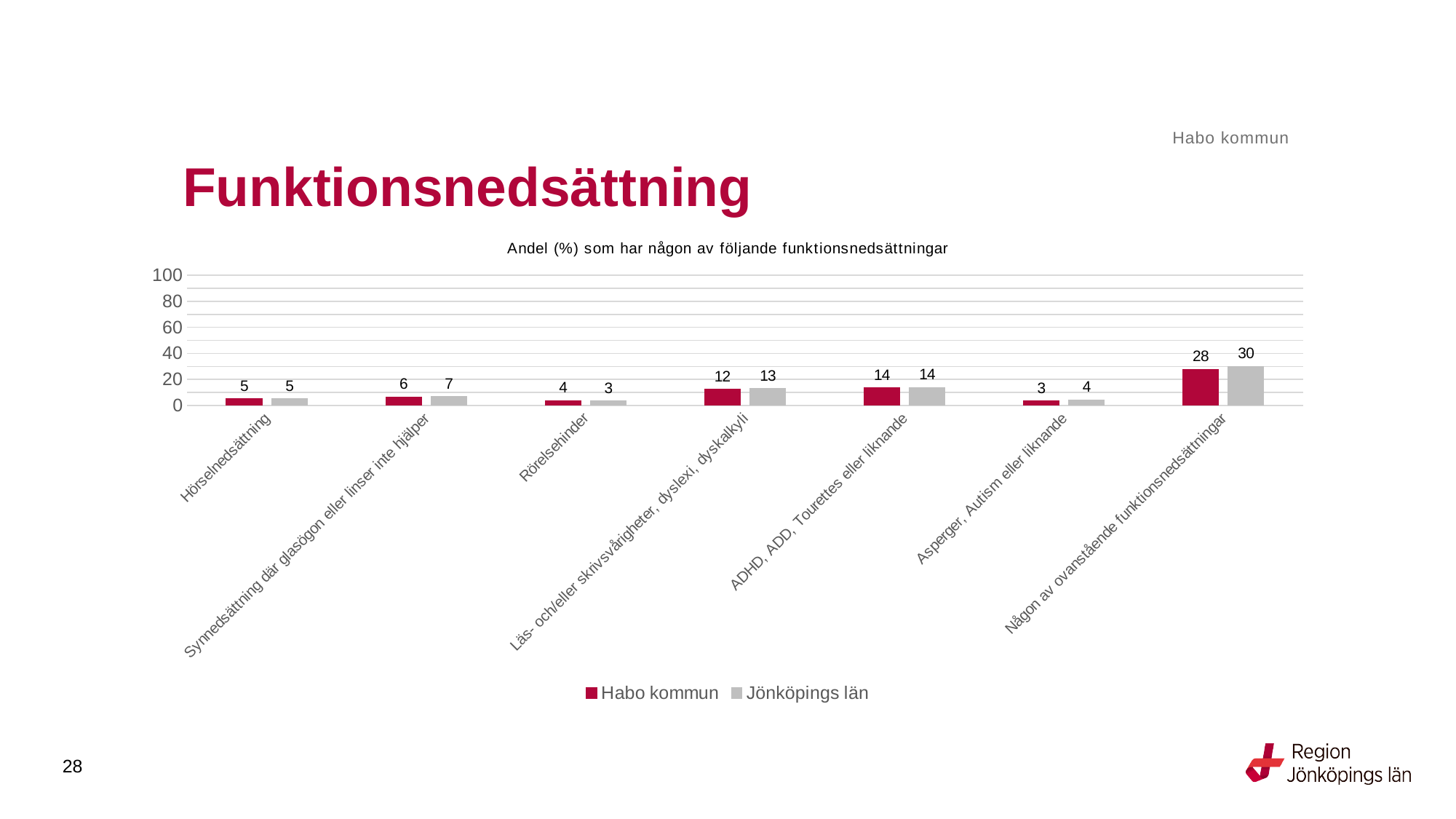
What is the value for Jönköpings län for Någon av ovanstående funktionsnedsättningar? 30 What is the value for Jönköpings län for Synnedsättning där glasögon eller linser inte hjälper? 7 How many categories are shown on the x axis? 7 What is the difference between Jönköpings län and Habo kommun for Någon av ovanstående funktionsnedsättningar? 2 Is the value for Habo kommun for ADHD, ADD, Tourettes eller liknande greater or less than 20? less How many series does the legend list? 2 What kind of chart is shown on the slide? bar chart Which category has the lowest value for Habo kommun? Asperger, Autism eller liknande Which is larger for Rörelsehinder: Habo kommun or Jönköpings län? Habo kommun What is the value for Habo kommun for Hörselnedsättning? 5 Which category has the highest value for Habo kommun? Någon av ovanstående funktionsnedsättningar What is the value for Habo kommun for Läs- och/eller skrivsvårigheter, dyslexi, dyskalkyli? 12